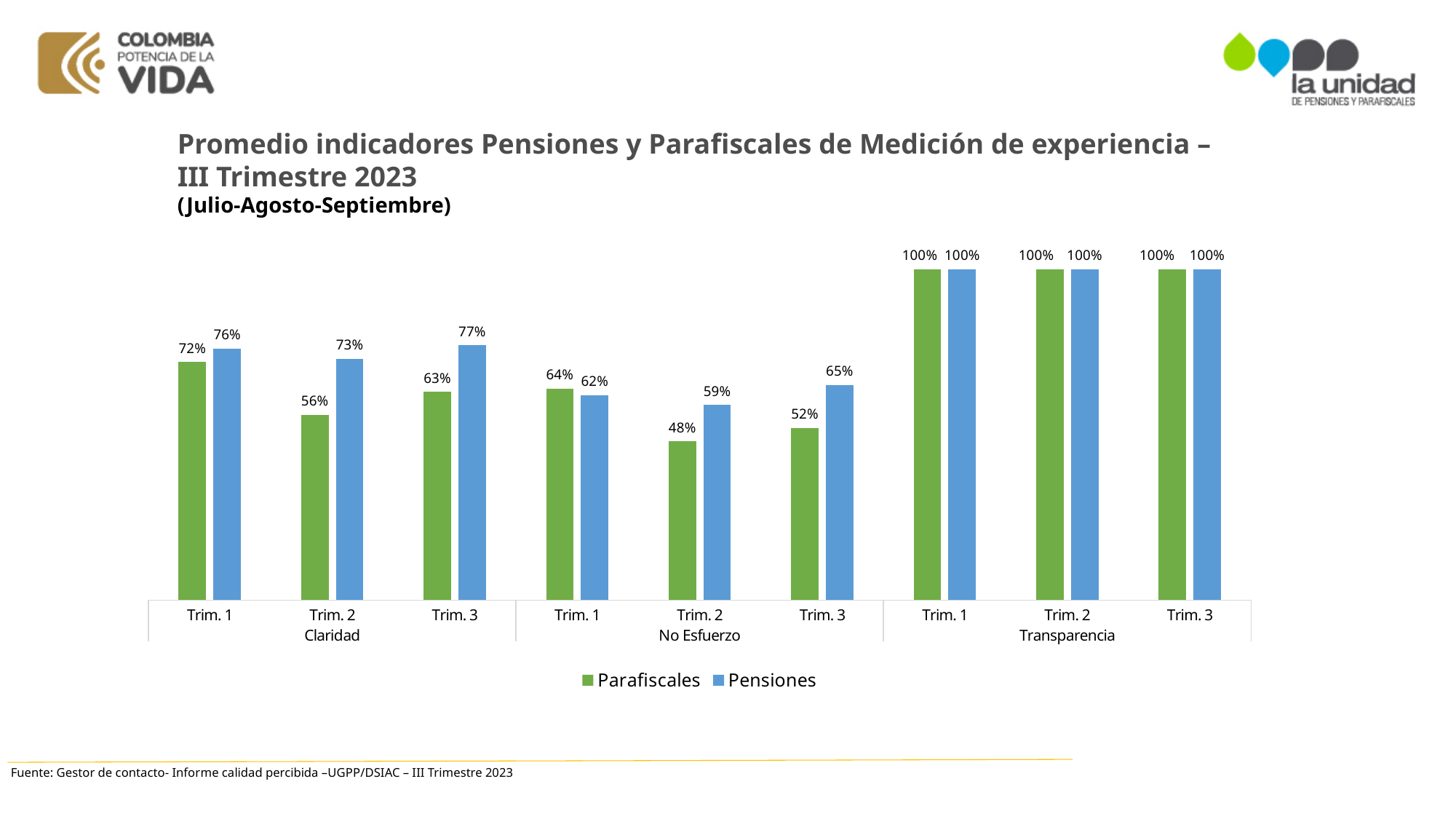
Which quarter has the highest Pensiones value under Claridad? Trim. 3 What value do all bars under Transparencia show? 100% What kind of chart is shown on the slide? Bar chart What is the Pensiones value for Trim. 3 under No Esfuerzo? 65% Which is larger for Trim. 1 under No Esfuerzo, Parafiscales or Pensiones? Parafiscales How many series does the legend list? 2 What is the Parafiscales value for Trim. 1 under Claridad? 72% What is the Pensiones value for Trim. 3 under Claridad? 77% What is the Parafiscales value for Trim. 2 under No Esfuerzo? 48% Which quarter has the lowest Parafiscales value under No Esfuerzo? Trim. 2 What is the difference between the Pensiones and Parafiscales values for Trim. 2 under Claridad? 17% Which colour represents Pensiones in the chart? Blue